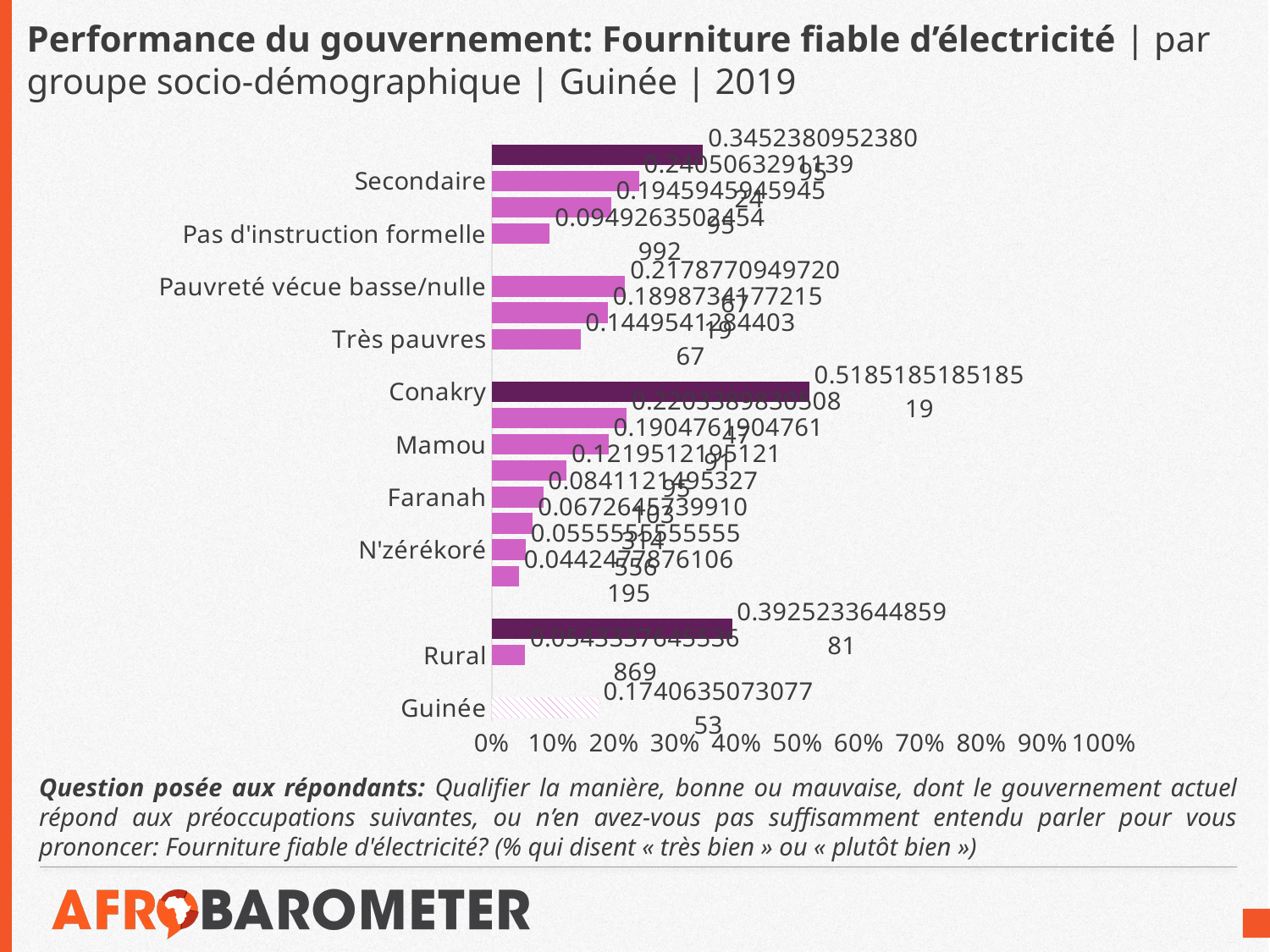
Is the value for Guinée greater or less than 20%? less What is the value shown for Conakry? 0.5185185185185 Is the value for N'zérékoré greater or less than 10%? less Is the value for Conakry greater or less than 40%? greater Which is larger, the value for Pauvreté vécue basse/nulle or the value for Très pauvres? Pauvreté vécue basse/nulle What is the highest value shown on the x axis of the chart? 100% Which is larger, the value for Conakry or the value for Guinée? Conakry What year is given in the chart title? 2019 What is the value shown for N'zérékoré? 0.0555555555555 Which category has the highest value in the chart? Conakry What kind of chart is shown on the slide? bar chart What is the value shown for Guinée? 0.1740635073077